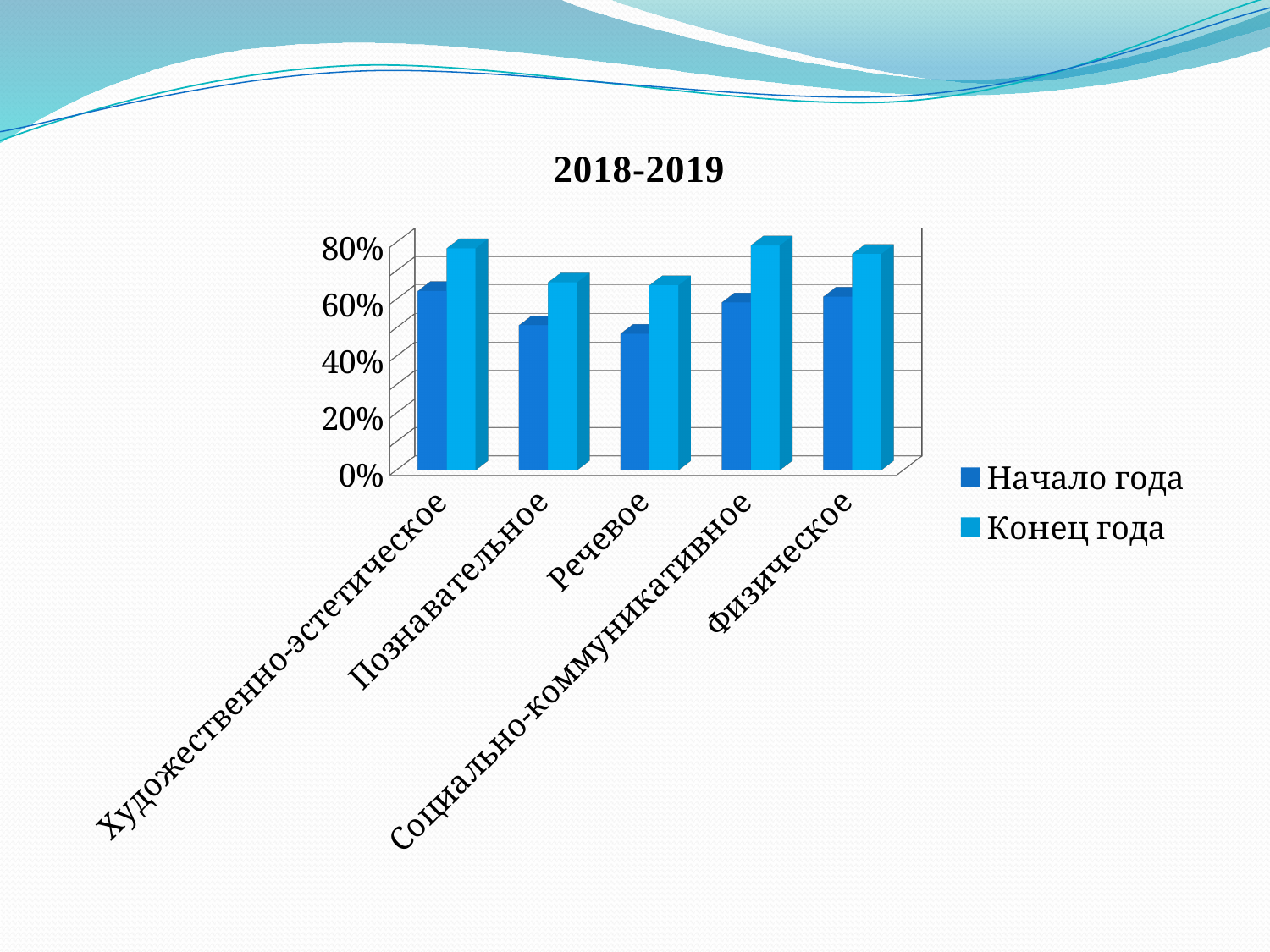
For Речевое, which series has the larger value, Начало года or Конец года? Конец года What are the two series named in the legend? Начало года, Конец года Is the value for Социально-коммуникативное in the Конец года series greater or less than 60%? greater What kind of chart is shown on the slide? bar chart For Физическое, which series has the larger value, Начало года or Конец года? Конец года In the Начало года series, which is larger, Художественно-эстетическое or Речевое? Художественно-эстетическое How many categories are shown on the x axis? 5 Is the value for Речевое in the Начало года series greater or less than 60%? less Is the value for Художественно-эстетическое in the Конец года series greater or less than 60%? greater How many series does the legend list? 2 What is the title of the chart? 2018-2019